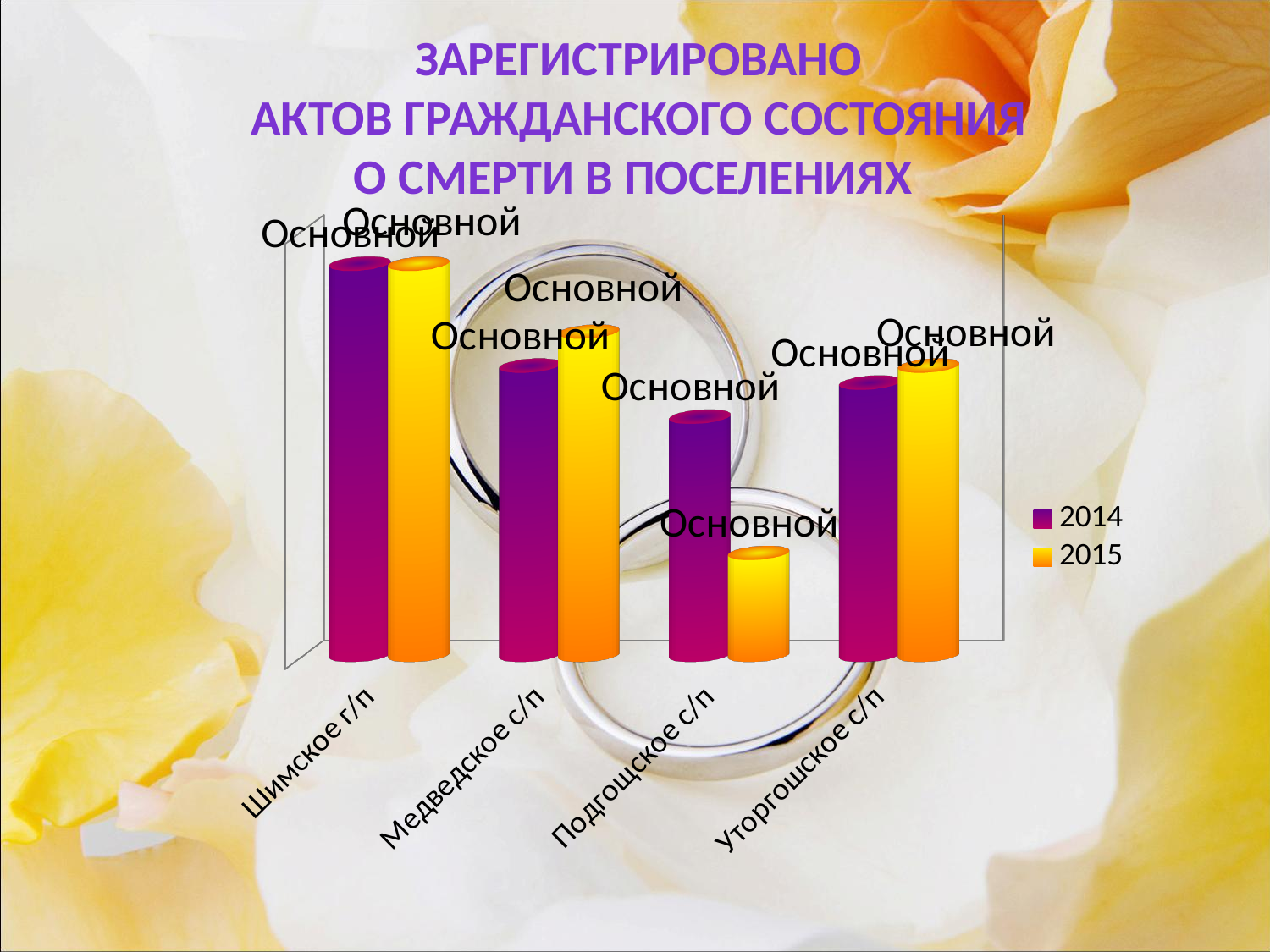
Which settlement has the lowest value for 2014? Подгощское с/п What kind of chart is shown on the slide? bar chart Which is larger: the 2014 value for Медведское с/п or the 2014 value for Подгощское с/п? Медведское с/п Which colour represents the 2015 series in the chart? yellow/orange How many categories (settlements) are shown on the x axis of the chart? 4 For Подгощское с/п, which year has the larger value, 2014 or 2015? 2014 Which settlement has the highest value for 2015? Шимское г/п Which settlement has the lowest value for 2015? Подгощское с/п Which is larger: the 2015 value for Шимское г/п or the 2015 value for Подгощское с/п? Шимское г/п Which settlement has the highest value for 2014? Шимское г/п How many series does the chart legend list? 2 Which years are listed in the chart legend? 2014 and 2015